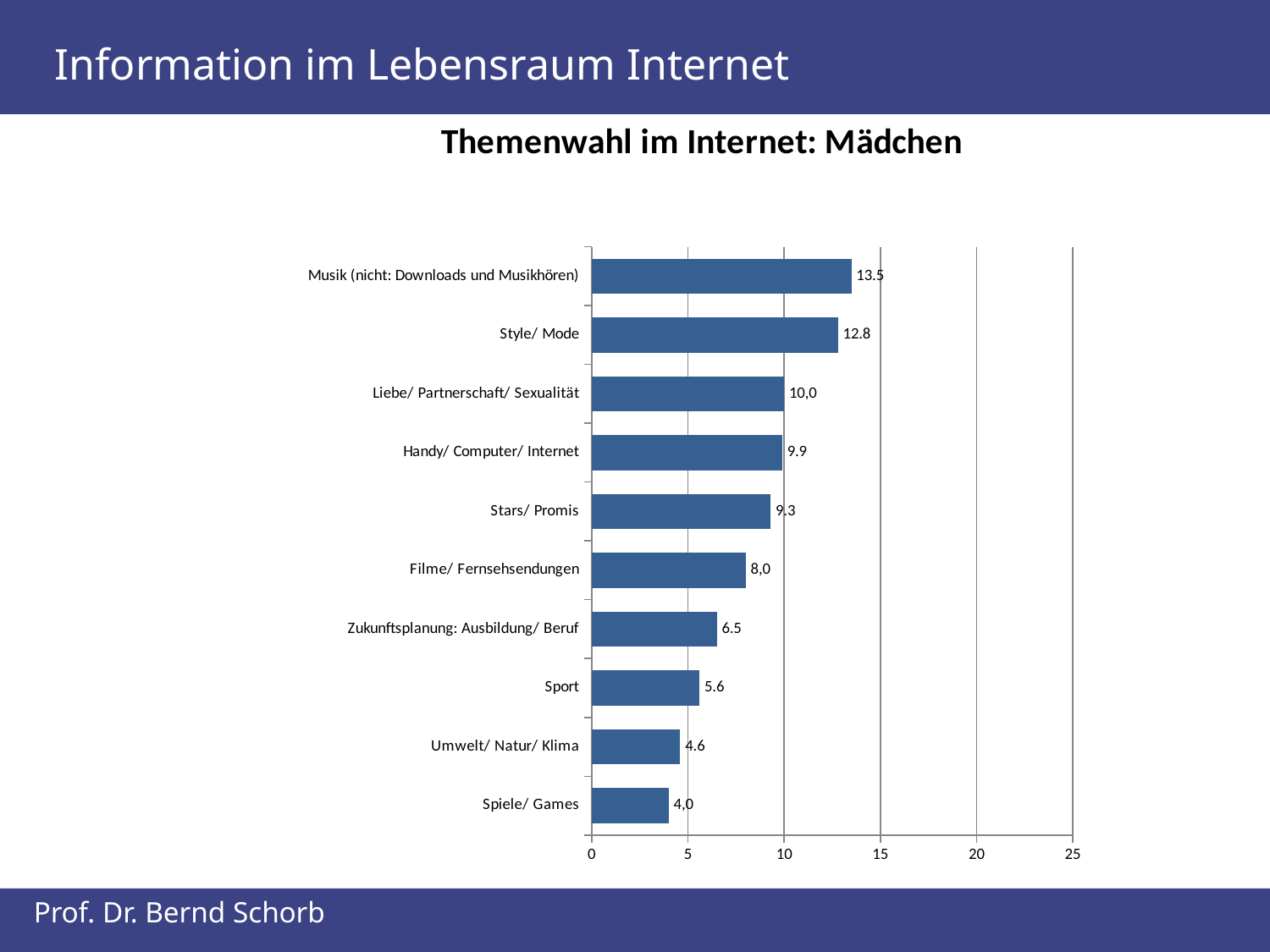
Which is larger, the value for Stars/ Promis or the value for Sport? Stars/ Promis What is the value for Filme/ Fernsehsendungen? 8,0 What is the difference between the values for Handy/ Computer/ Internet and Umwelt/ Natur/ Klima? 5.3 What is the value for Style/ Mode? 12.8 Which category has the highest value? Musik (nicht: Downloads und Musikhören) Which category has the lowest value? Spiele/ Games How many categories are shown in the chart? 10 What is the difference between the values for Musik (nicht: Downloads und Musikhören) and Sport? 7.9 What is the title of the chart? Themenwahl im Internet: Mädchen What type of chart is shown on the slide? bar chart What is the value for Umwelt/ Natur/ Klima? 4.6 What is the value for Zukunftsplanung: Ausbildung/ Beruf? 6.5